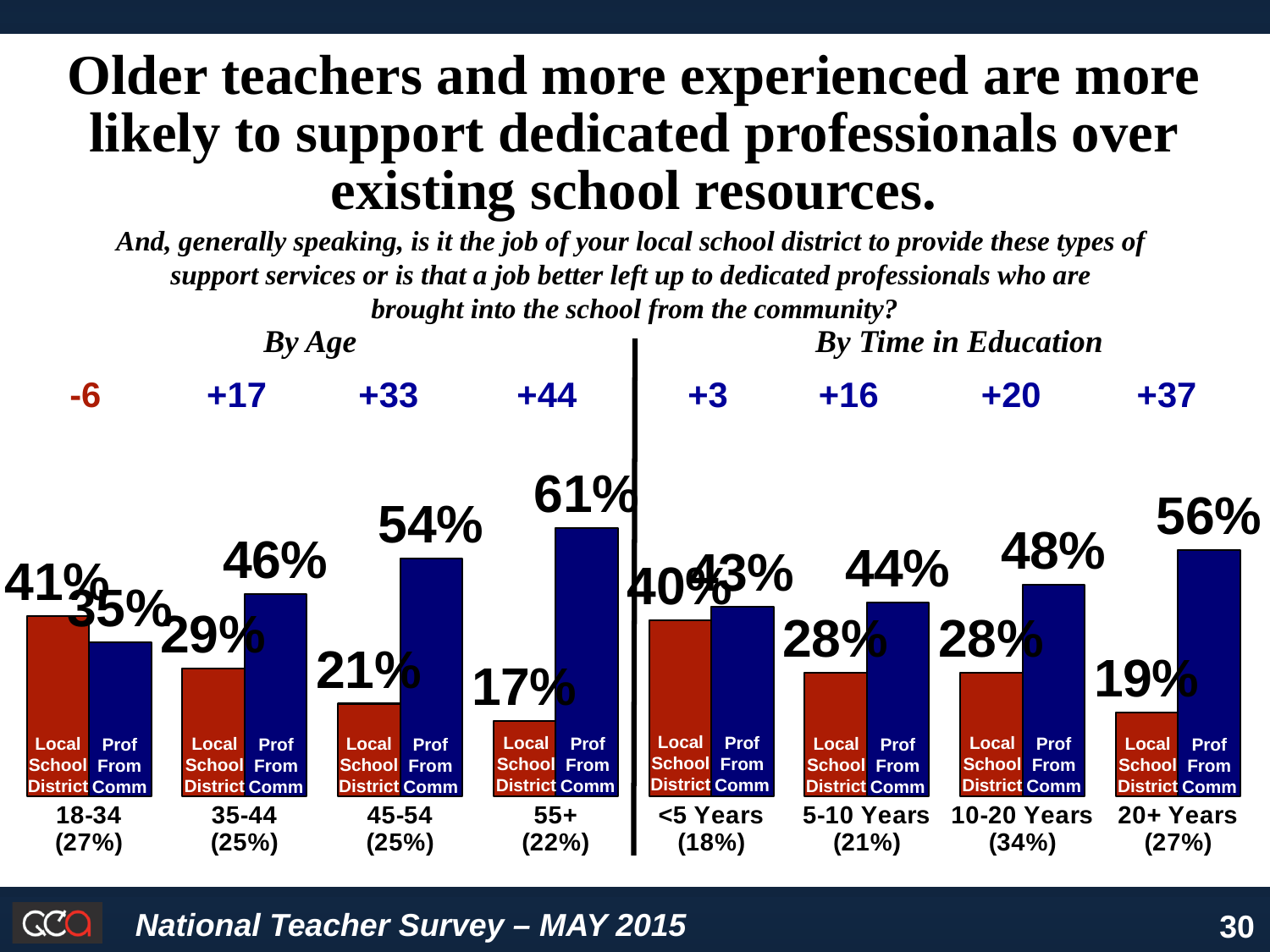
In the 'By Time in Education' chart, which group has the lowest 'Local School District' value? 20+ Years In the 'By Time in Education' chart, which is larger for the 5-10 Years group: 'Local School District' or 'Prof From Comm'? Prof From Comm In the 'By Age' chart, which age group has the highest 'Prof From Comm' value? 55+ In the 'By Time in Education' chart, what net figure is shown above the 10-20 Years group? +20 How many age groups are shown in the 'By Age' chart? 4 In the 'By Time in Education' chart, what percentage of teachers with 20+ years chose 'Prof From Comm'? 56% What type of chart is used on this slide? Bar chart In the 'By Age' chart, does the 'Prof From Comm' value rise or fall as age increases from 18-34 to 55+? Rise In the 'By Age' chart, what percentage of teachers aged 55+ chose 'Prof From Comm'? 61% In the 'By Age' chart, what is the difference between the 'Prof From Comm' and 'Local School District' values for the 45-54 group? 33 percentage points In the 'By Time in Education' chart, what percentage of teachers with <5 years chose 'Local School District'? 40% In the 'By Age' chart, what percentage of teachers aged 18-34 chose 'Local School District'? 41%